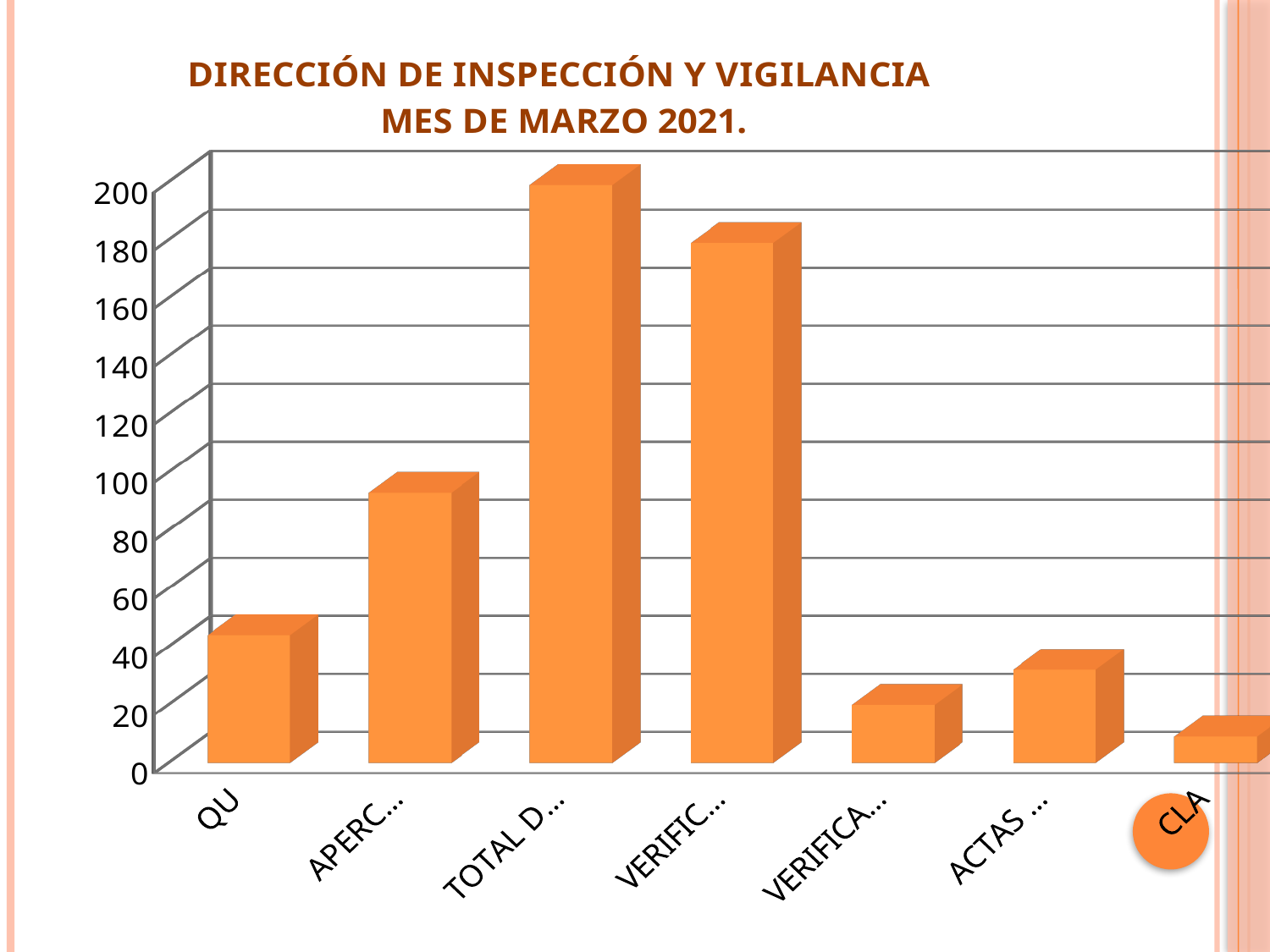
Is the value of the fifth bar from the left (VERIFICA...) greater or less than 40? less Which is larger, the second bar from the left (APERC...) or the fourth bar from the left (VERIFIC...)? the fourth bar (VERIFIC...) What is the highest value labelled on the vertical axis? 200 Is the value of the first bar from the left (QU) greater or less than 60? less How many bars are plotted in the chart? 7 Which bar is the lowest in the chart? the last bar on the right (CLA) Is the value of the fourth bar from the left (VERIFIC...) greater or less than 160? greater What kind of chart is shown on the slide? bar chart What is the title of the chart? DIRECCIÓN DE INSPECCIÓN Y VIGILANCIA MES DE MARZO 2021. Which is larger, the fifth bar from the left (VERIFICA...) or the sixth bar from the left (ACTAS ...)? the sixth bar (ACTAS ...) Which bar is the highest in the chart? the third bar from the left (TOTAL D...)